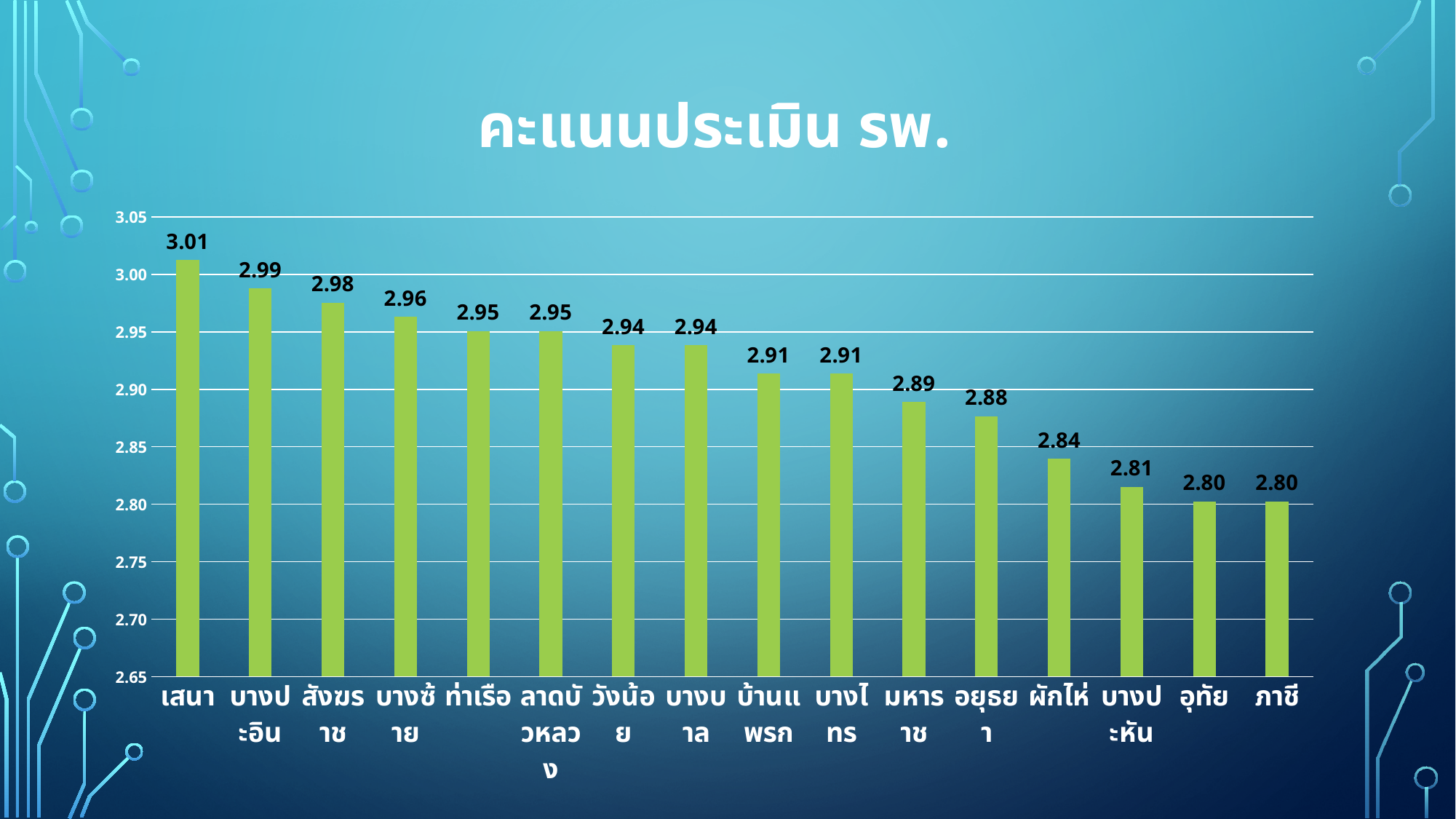
What is the evaluation score for มหาราช? 2.89 What is the evaluation score for ผักไห่? 2.84 Which has a higher score, สังฆราช or บางปะหัน? สังฆราช What is the title of the chart? คะแนนประเมิน รพ. Which hospital has the highest evaluation score? เสนา What is the evaluation score for เสนา? 3.01 Do the scores rise or fall from left to right across the chart? fall What is the difference between the scores of เสนา and ภาชี? 0.21 What is the difference between the scores of บางซ้าย and อยุธยา? 0.08 Is the score for อุทัย greater or less than 2.85? less How many hospitals are shown in the chart? 16 What kind of chart is shown on the slide? bar chart